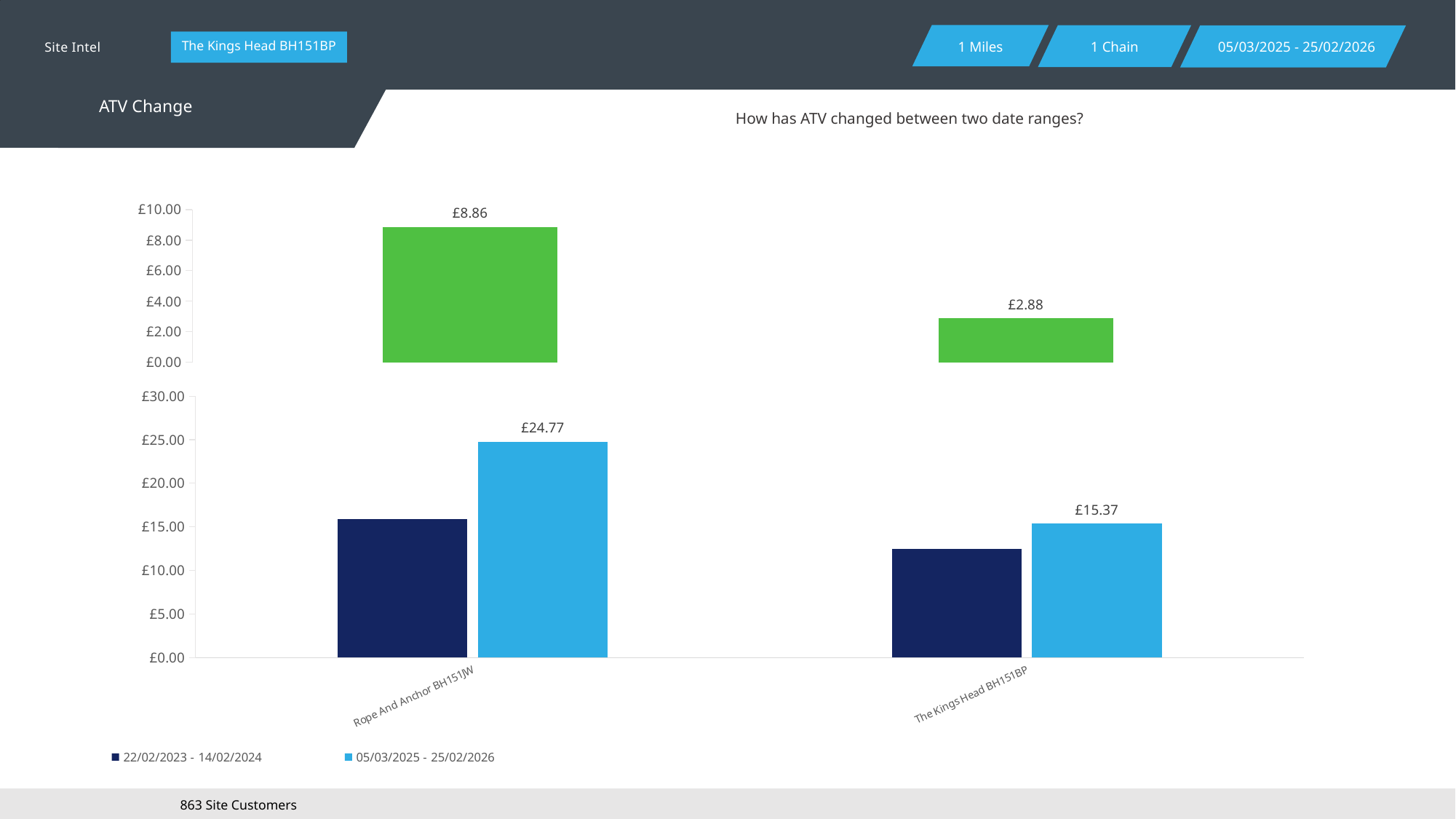
In the bottom chart, is the 22/02/2023 - 14/02/2024 value for The Kings Head BH151BP greater or less than £15.00? less In the top chart, which category has the highest value? Rope And Anchor BH151JW How many series does the legend of the bottom chart list? 2 In the bottom chart, what is the difference between the 05/03/2025 - 25/02/2026 values for Rope And Anchor BH151JW and The Kings Head BH151BP? £9.40 In the bottom chart, what is the value for Rope And Anchor BH151JW in the 05/03/2025 - 25/02/2026 series? £24.77 What kind of chart is the bottom chart? bar chart In the top chart, what is the value shown for Rope And Anchor BH151JW? £8.86 In the bottom chart, for Rope And Anchor BH151JW, which series has the larger value: 22/02/2023 - 14/02/2024 or 05/03/2025 - 25/02/2026? 05/03/2025 - 25/02/2026 In the bottom chart, is the 22/02/2023 - 14/02/2024 value for The Kings Head BH151BP greater or less than £10.00? greater In the top chart, what is the value shown for The Kings Head BH151BP? £2.88 In the bottom chart, what is the value for The Kings Head BH151BP in the 05/03/2025 - 25/02/2026 series? £15.37 In the top chart, what is the difference between the values for Rope And Anchor BH151JW and The Kings Head BH151BP? £5.98